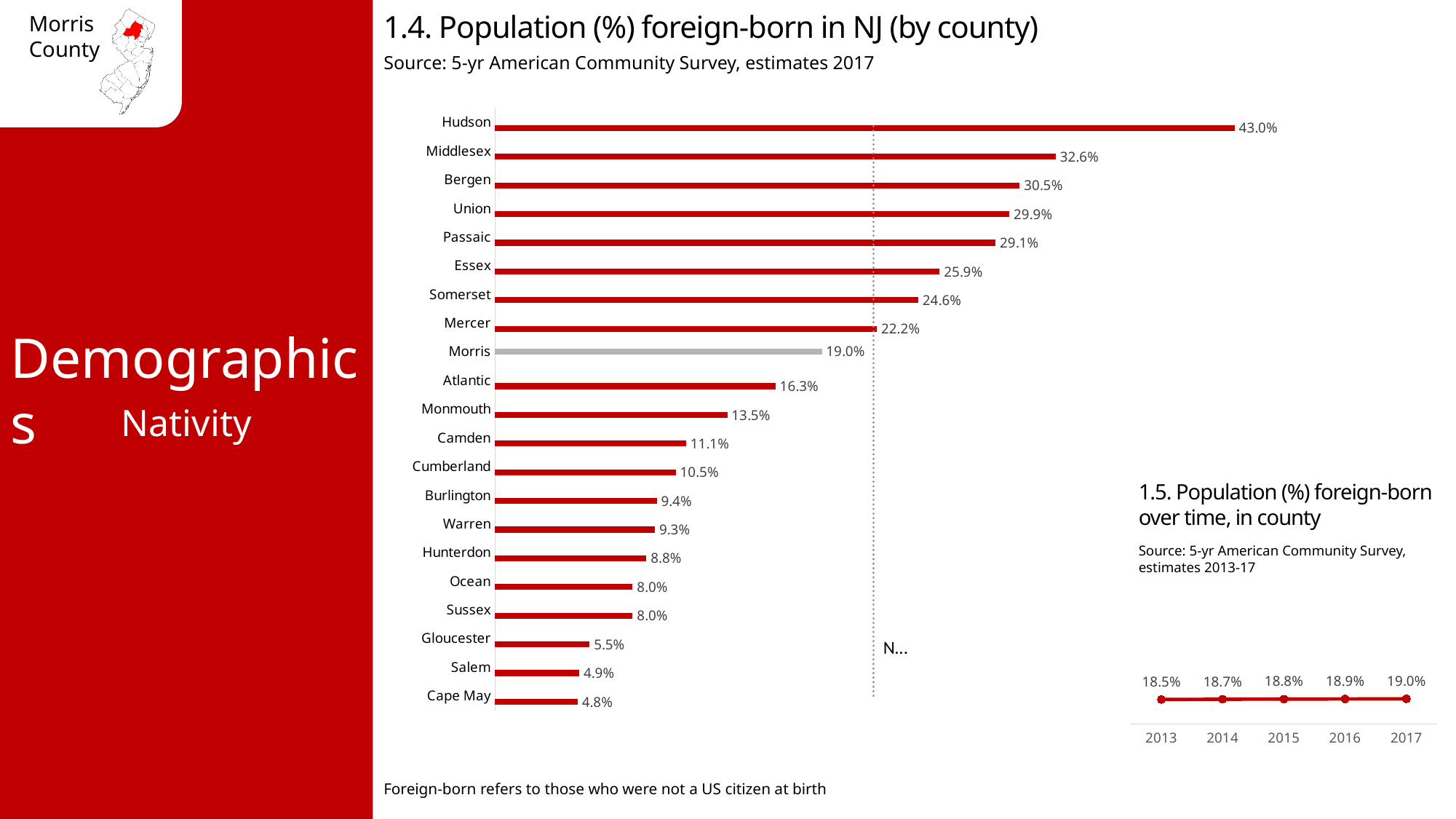
How many data points are plotted in the chart '1.5. Population (%) foreign-born over time, in county'? 5 What kind of chart is '1.4. Population (%) foreign-born in NJ (by county)'? Bar chart In the chart '1.5. Population (%) foreign-born over time, in county', what is the value for 2015? 18.8% In the chart '1.4. Population (%) foreign-born in NJ (by county)', which bar is coloured grey instead of red? Morris In the chart '1.4. Population (%) foreign-born in NJ (by county)', which is larger, Essex or Somerset? Essex In the chart '1.4. Population (%) foreign-born in NJ (by county)', which county has the lowest value? Cape May In the chart '1.4. Population (%) foreign-born in NJ (by county)', which county has the highest value? Hudson In the chart '1.4. Population (%) foreign-born in NJ (by county)', what is the difference between Hudson and Middlesex? 10.4% In the chart '1.5. Population (%) foreign-born over time, in county', do the values rise or fall from 2013 to 2017? Rise How many counties are shown in the chart '1.4. Population (%) foreign-born in NJ (by county)'? 21 In the chart '1.4. Population (%) foreign-born in NJ (by county)', what is the value for Bergen? 30.5% In the chart '1.4. Population (%) foreign-born in NJ (by county)', what is the value for Morris? 19.0%